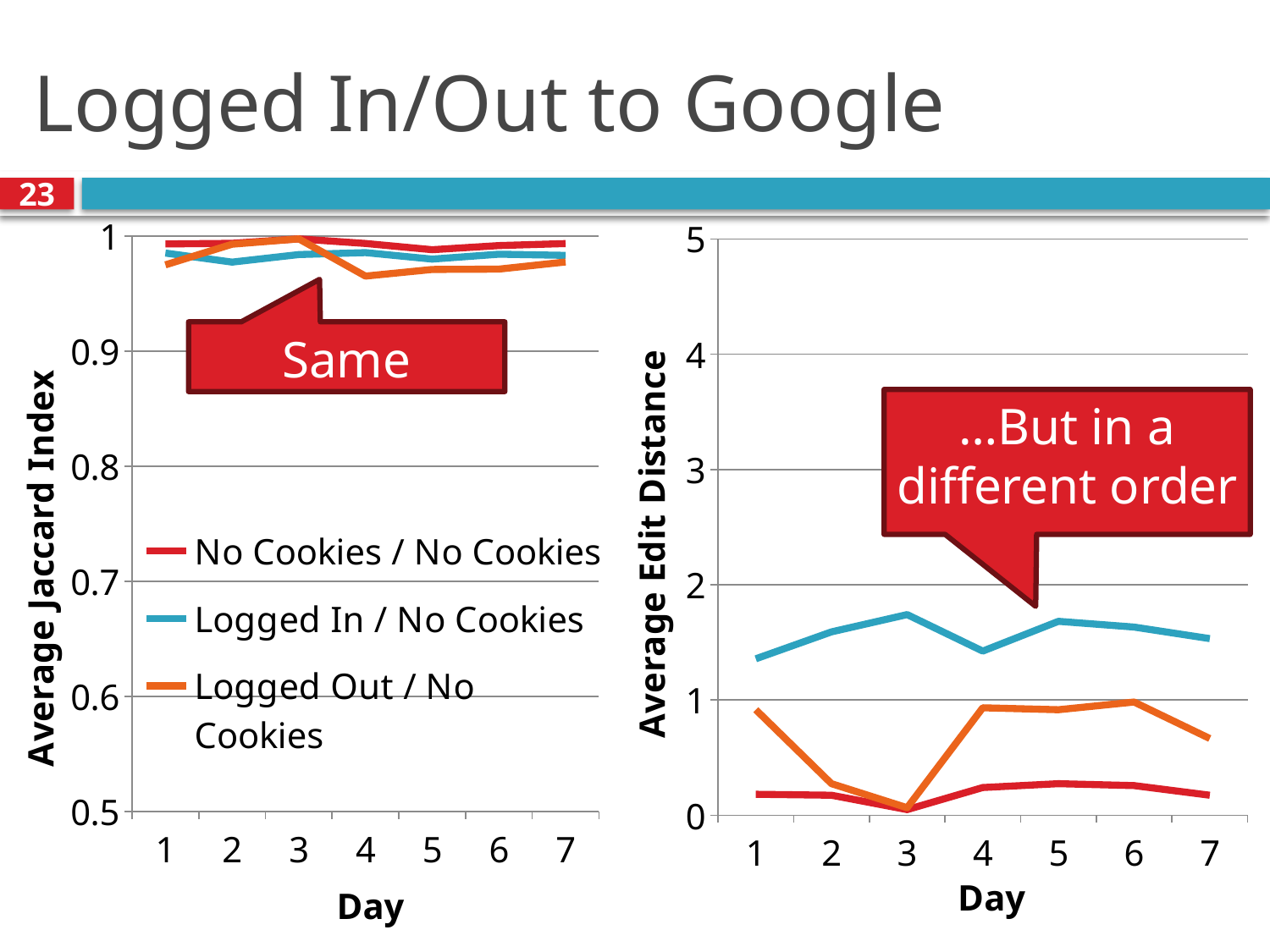
How many series does the legend on the left chart (Average Jaccard Index) list? 3 On the left chart (Average Jaccard Index), is the value for Logged In / No Cookies on day 1 greater or less than 0.9? greater On the right chart (Average Edit Distance), is the value of the blue line on day 3 greater or less than 2? less What is the y-axis title of the right chart? Average Edit Distance On the right chart (Average Edit Distance), which line has the larger value on day 5, the blue line or the red line? the blue line What is the x-axis title of the left chart? Day How many days are plotted along the x axis of the right chart (Average Edit Distance)? 7 On the right chart (Average Edit Distance), is the value of the blue line on day 1 greater or less than 1? greater On the right chart (Average Edit Distance), which line has the larger value on day 4, the orange line or the red line? the orange line What kind of chart is the left chart (Average Jaccard Index)? line chart